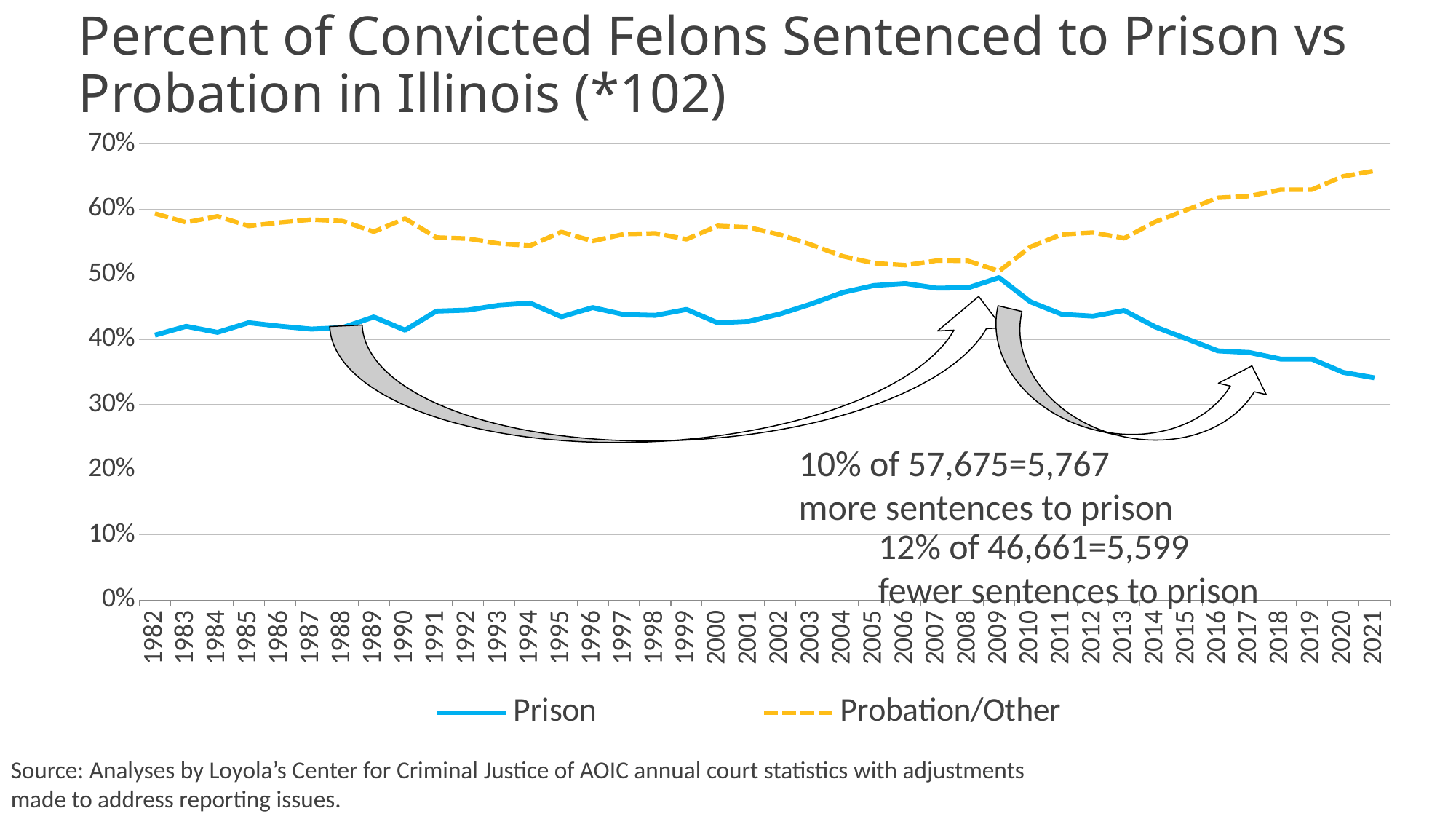
In which year is the Probation/Other series at its lowest value? 2009 What is the first year shown on the x axis? 1982 In which year is the Prison series at its lowest value? 2021 How many series does the legend list? 2 Is the Prison value for 2021 greater or less than 40%? less Does the Prison series rise or fall from 2009 to 2021? Falls How many years are plotted along the x axis? 40 In which year does the Prison series reach its highest value? 2009 Is the Probation/Other value for 2021 greater or less than 60%? greater What kind of chart is shown on the slide? Line chart In which year does the Probation/Other series reach its highest value? 2021 Which two series are listed in the legend? Prison and Probation/Other